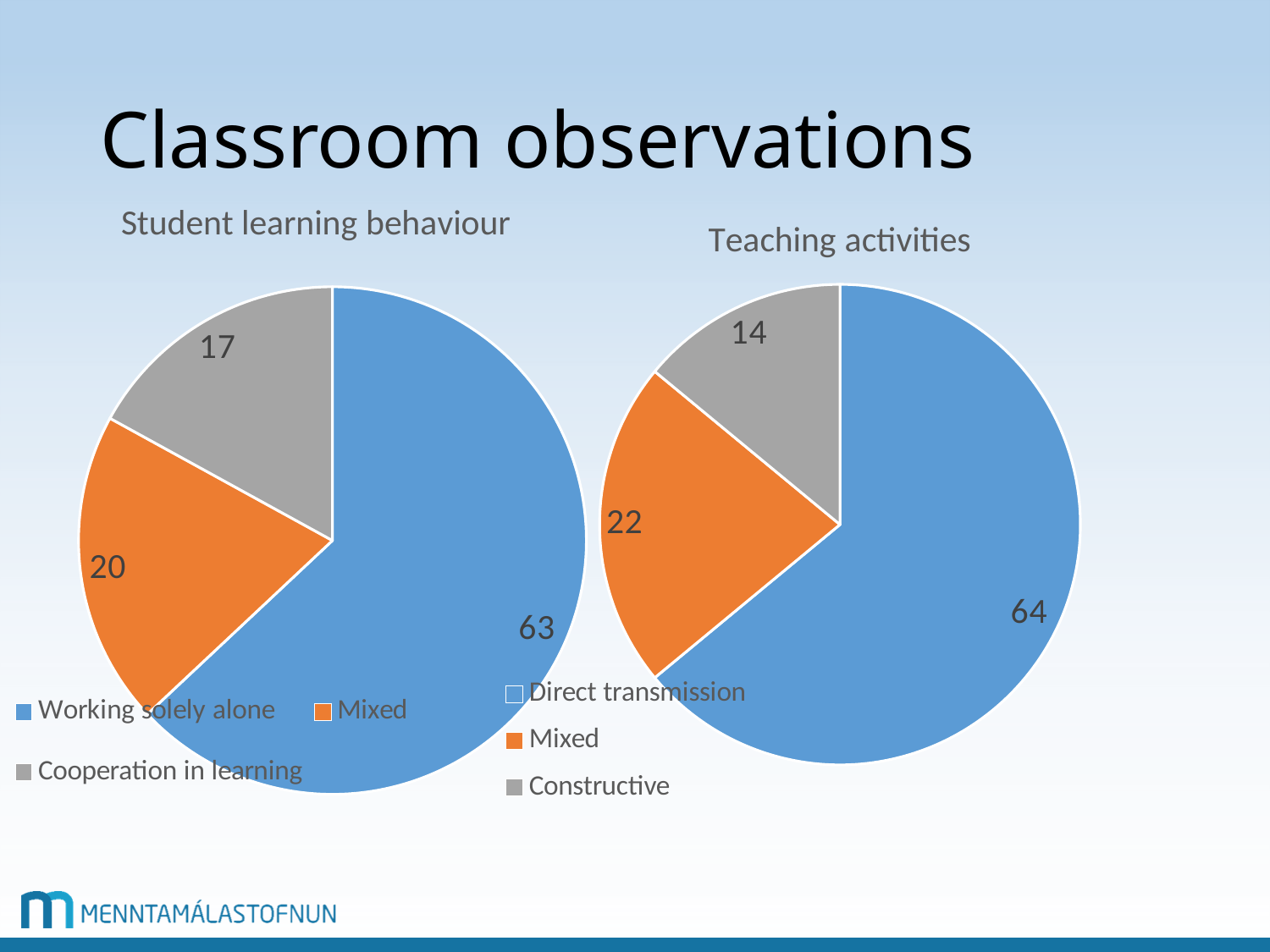
In the 'Teaching activities' chart, which category has the largest slice? Direct transmission In the 'Student learning behaviour' chart, what is the value for Working solely alone? 63 In the 'Student learning behaviour' chart, which category has the smallest slice? Cooperation in learning How many slices does the 'Teaching activities' chart have? 3 In the 'Student learning behaviour' chart, which colour represents Mixed? Orange In the 'Student learning behaviour' chart, what is the difference between Working solely alone and Mixed? 43 Which is larger: Mixed in the 'Student learning behaviour' chart or Mixed in the 'Teaching activities' chart? Mixed in the 'Teaching activities' chart In the 'Student learning behaviour' chart, what is the value for Cooperation in learning? 17 In the 'Teaching activities' chart, what is the value for Mixed? 22 In the 'Teaching activities' chart, what is the value for Constructive? 14 What kind of chart is the 'Student learning behaviour' chart? Pie chart In the 'Teaching activities' chart, what is the difference between Mixed and Constructive? 8